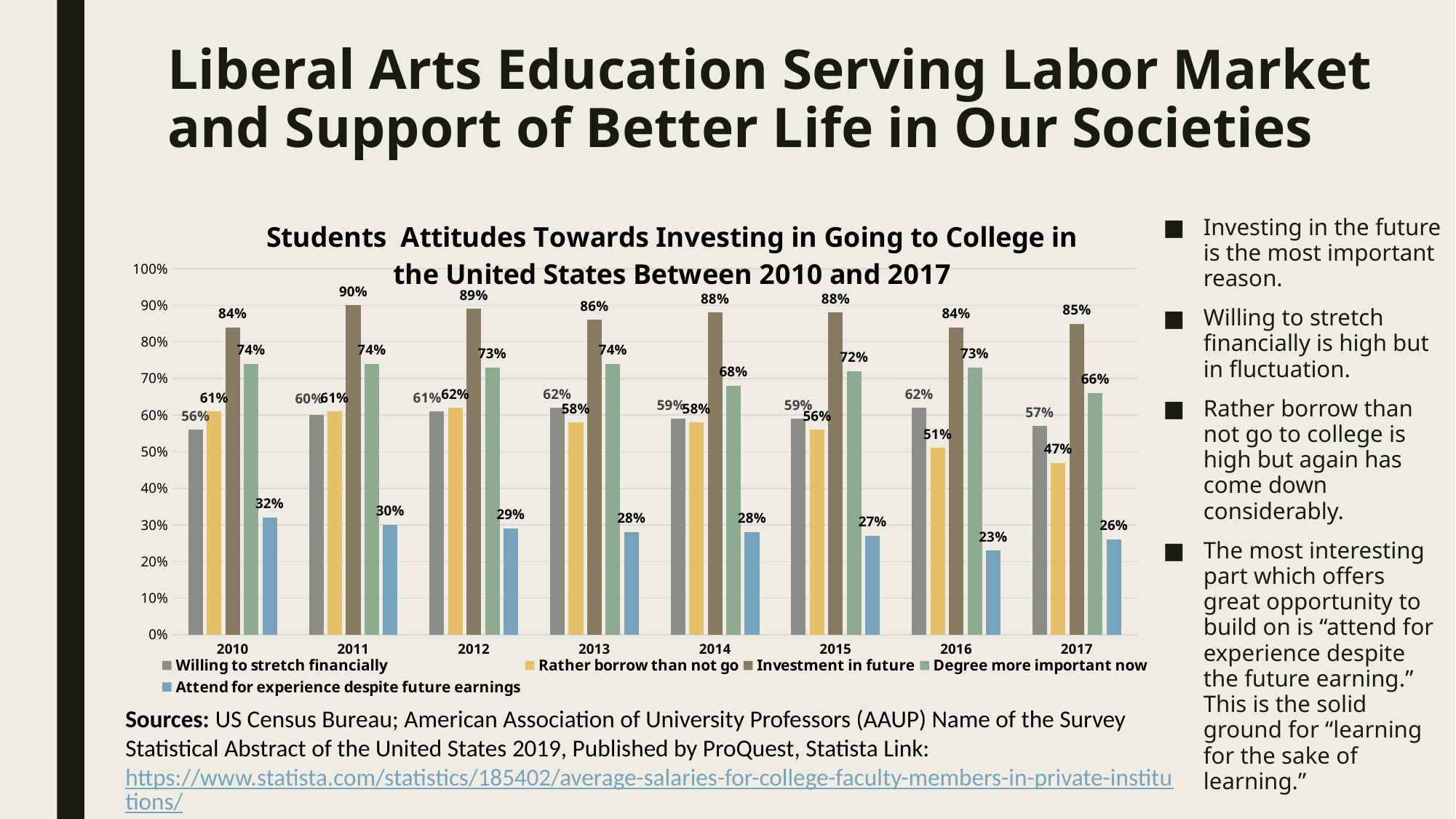
In which year is the Investment in future value highest? 2011 What is the difference between Investment in future and Degree more important now in 2014? 20% What is the title of the chart? Students Attitudes Towards Investing in Going to College in the United States Between 2010 and 2017 What is the value for Rather borrow than not go in 2017? 47% What kind of chart is shown on the slide? Bar chart What is the value for Attend for experience despite future earnings in 2016? 23% How many series does the legend list? 5 What is the value for Investment in future in 2011? 90% How many years are shown on the x axis? 8 Which is larger in 2013: Willing to stretch financially or Rather borrow than not go? Willing to stretch financially In which year is the Rather borrow than not go value lowest? 2017 Does the Rather borrow than not go series rise or fall from 2012 to 2017? Fall